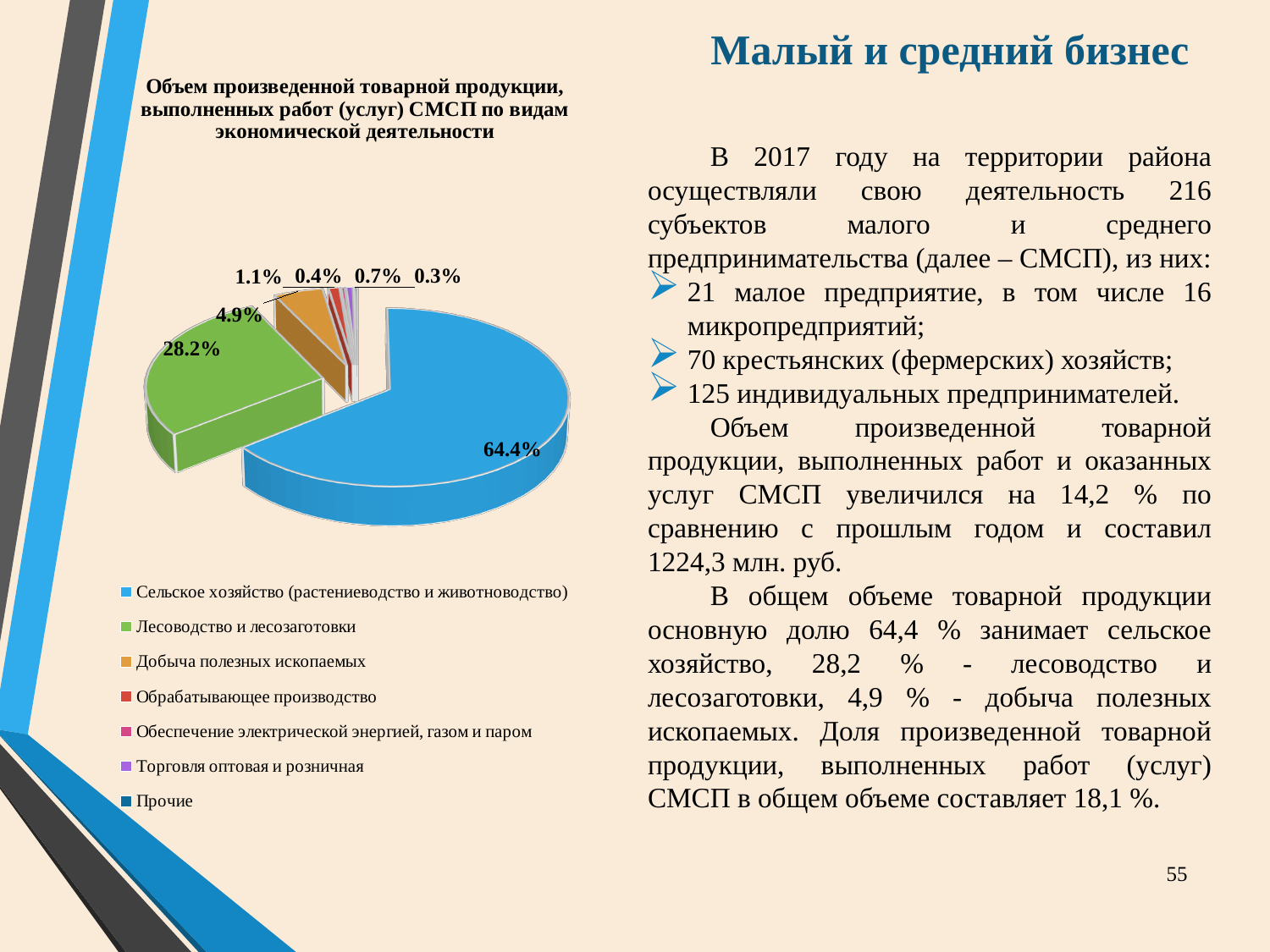
What is the difference in percentage points between the share of Сельское хозяйство and the share of Лесоводство и лесозаготовки? 36.2 What is the smallest percentage value labelled on the pie chart? 0.3% What colour is the slice for Сельское хозяйство (растениеводство и животноводство)? blue Which category has the largest share of the pie? Сельское хозяйство (растениеводство и животноводство) What share of the pie does Добыча полезных ископаемых have? 4.9% Which has a larger share: Лесоводство и лесозаготовки or Добыча полезных ископаемых? Лесоводство и лесозаготовки What share of the pie does Лесоводство и лесозаготовки have? 28.2% What is the combined share of the three largest slices (Сельское хозяйство, Лесоводство и лесозаготовки, Добыча полезных ископаемых)? 97.5% What share of the pie does Сельское хозяйство (растениеводство и животноводство) have? 64.4% How many categories does the pie chart show? 7 What is the title of the pie chart? Объем произведенной товарной продукции, выполненных работ (услуг) СМСП по видам экономической деятельности What kind of chart is shown on the slide? pie chart